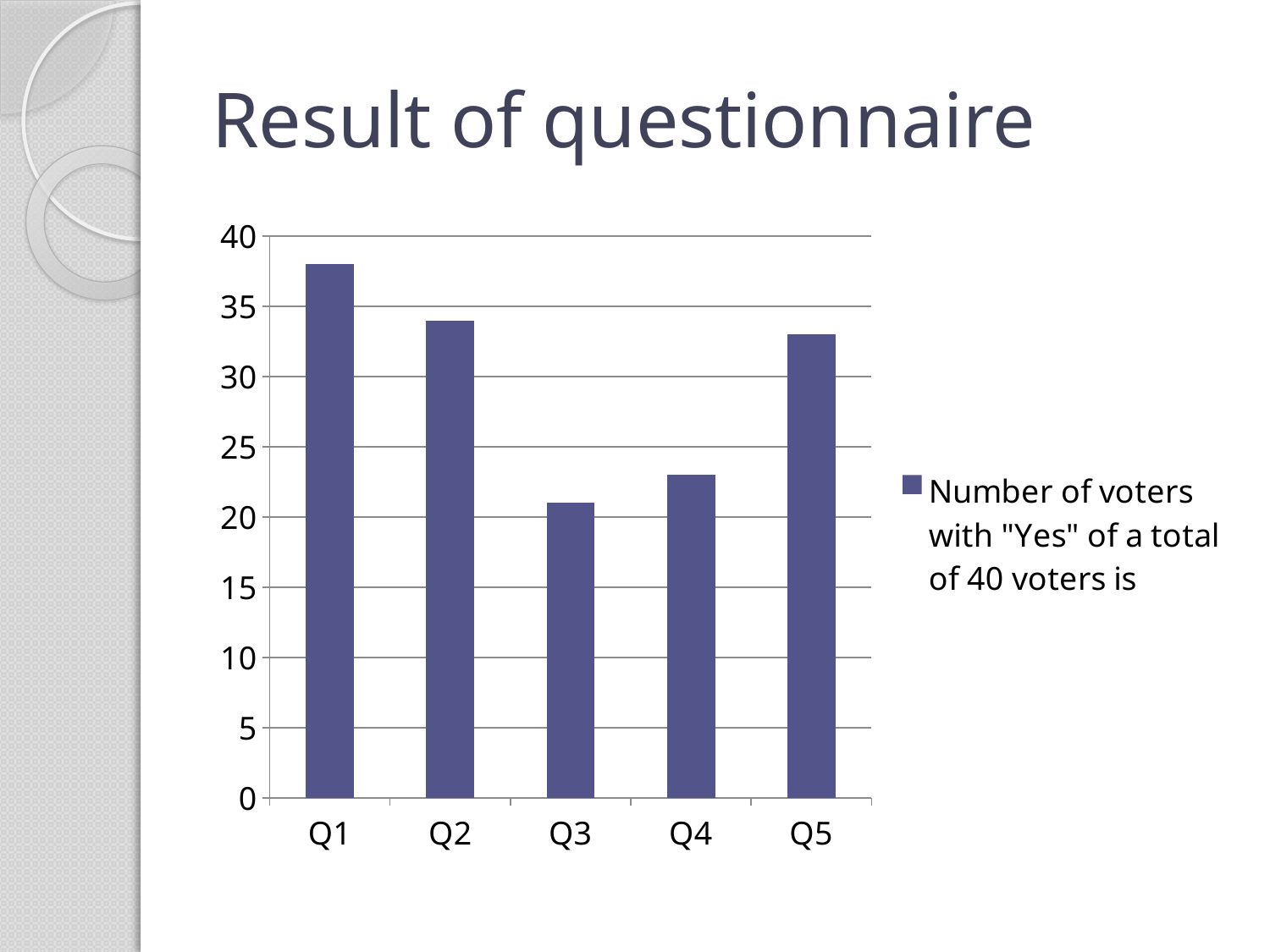
Which is larger, the value for Q2 or the value for Q4? Q2 What is the title of the slide containing the chart? Result of questionnaire How many categories are shown on the x axis of the chart? 5 What kind of chart is shown on the slide? bar chart How many series does the chart's legend list? 1 Which is larger, the value for Q1 or the value for Q2? Q1 Is the value for Q1 greater or less than 35? greater Is the value for Q3 greater or less than 25? less Which question has the lowest number of voters with "Yes"? Q3 Is the value for Q5 greater or less than 30? greater Which question has the highest number of voters with "Yes"? Q1